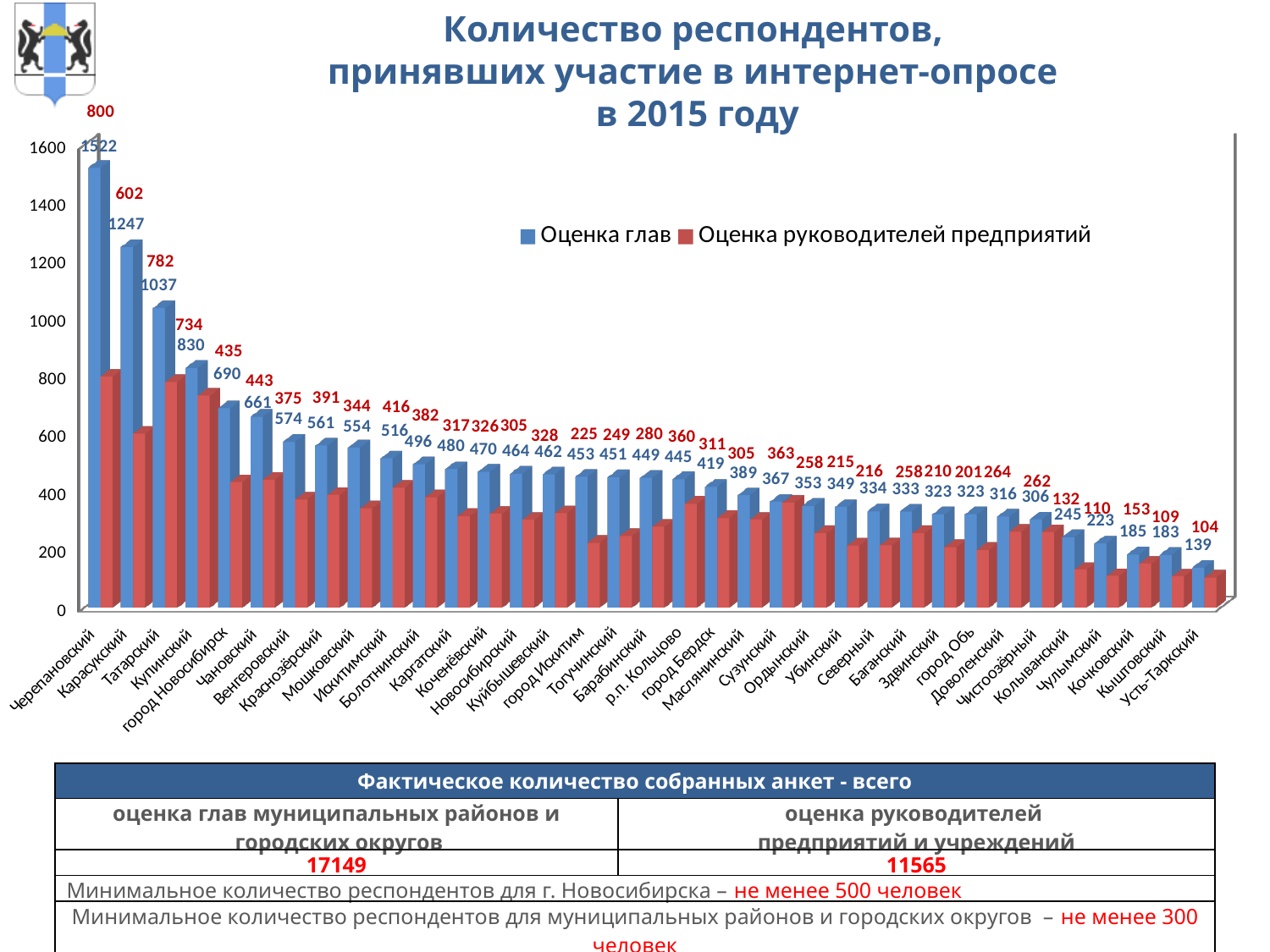
Which category has the highest value for 'Оценка глав'? Черепановский What type of chart is shown on the slide? bar chart What is the value of 'Оценка глав' for Черепановский? 1522 Do the 'Оценка глав' values generally rise or fall from left to right along the x axis? fall How many series does the chart legend list? 2 What is the difference between 'Оценка глав' and 'Оценка руководителей предприятий' for Карасукский? 645 What is the value of 'Оценка руководителей предприятий' for Усть-Таркский? 104 What are the two series named in the chart legend? Оценка глав; Оценка руководителей предприятий Which is larger for Купинский: 'Оценка глав' or 'Оценка руководителей предприятий'? Оценка глав What is the value of 'Оценка руководителей предприятий' for Татарский? 782 What is the value of 'Оценка глав' for город Новосибирск? 690 Which category has the lowest value for 'Оценка руководителей предприятий'? Усть-Таркский